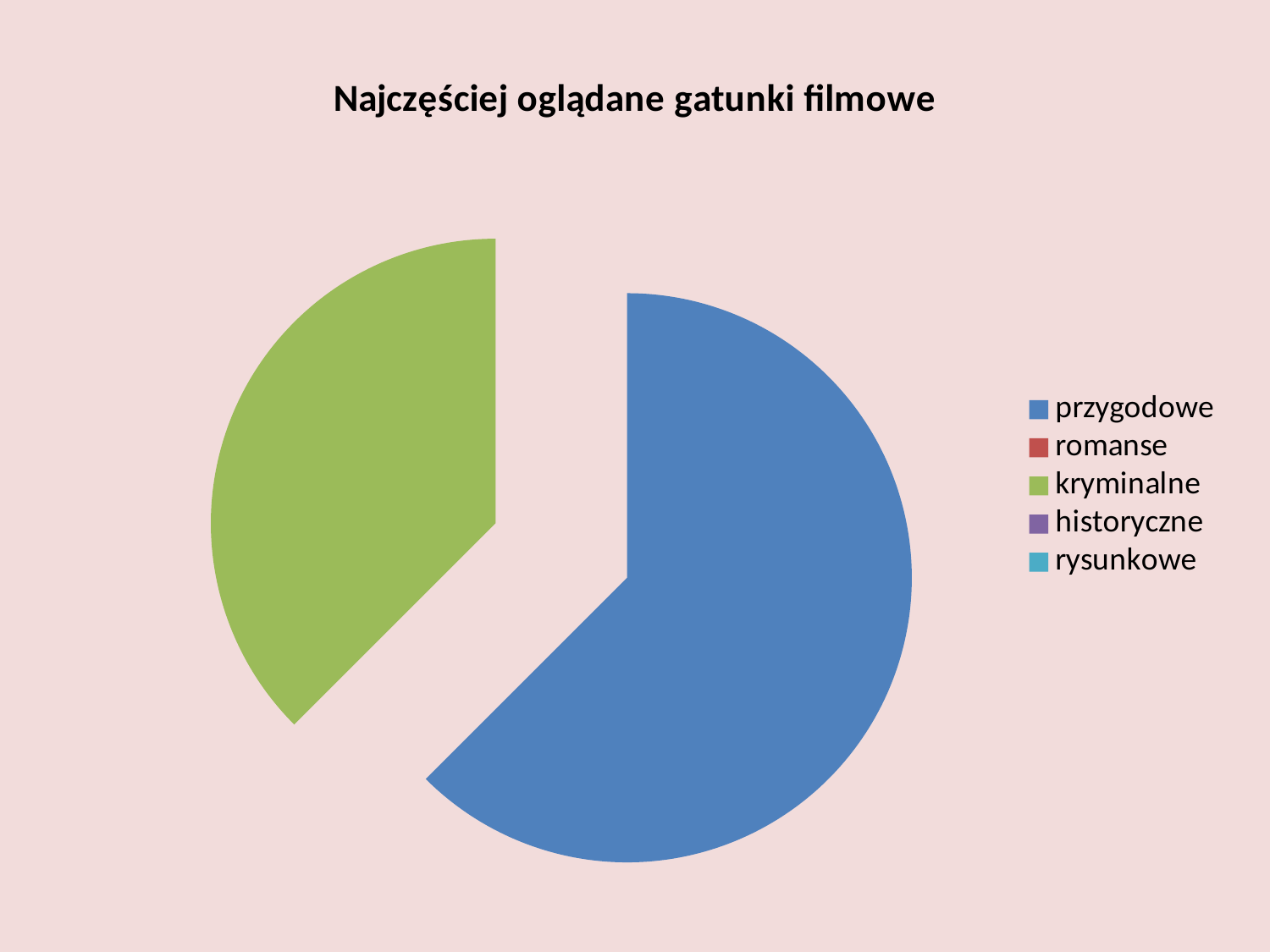
Is the share of przygodowe greater or less than 50%? greater How many entries does the legend list? 5 Which category has the largest slice of the pie? przygodowe What kind of chart is shown on the slide? pie chart What is the title of the chart? Najczęściej oglądane gatunki filmowe Which slice is larger, przygodowe or kryminalne? przygodowe Which colour represents kryminalne in the chart? green Is the share of kryminalne greater or less than 50%? less How many slices are visible in the pie? 2 Which category is shown in blue? przygodowe